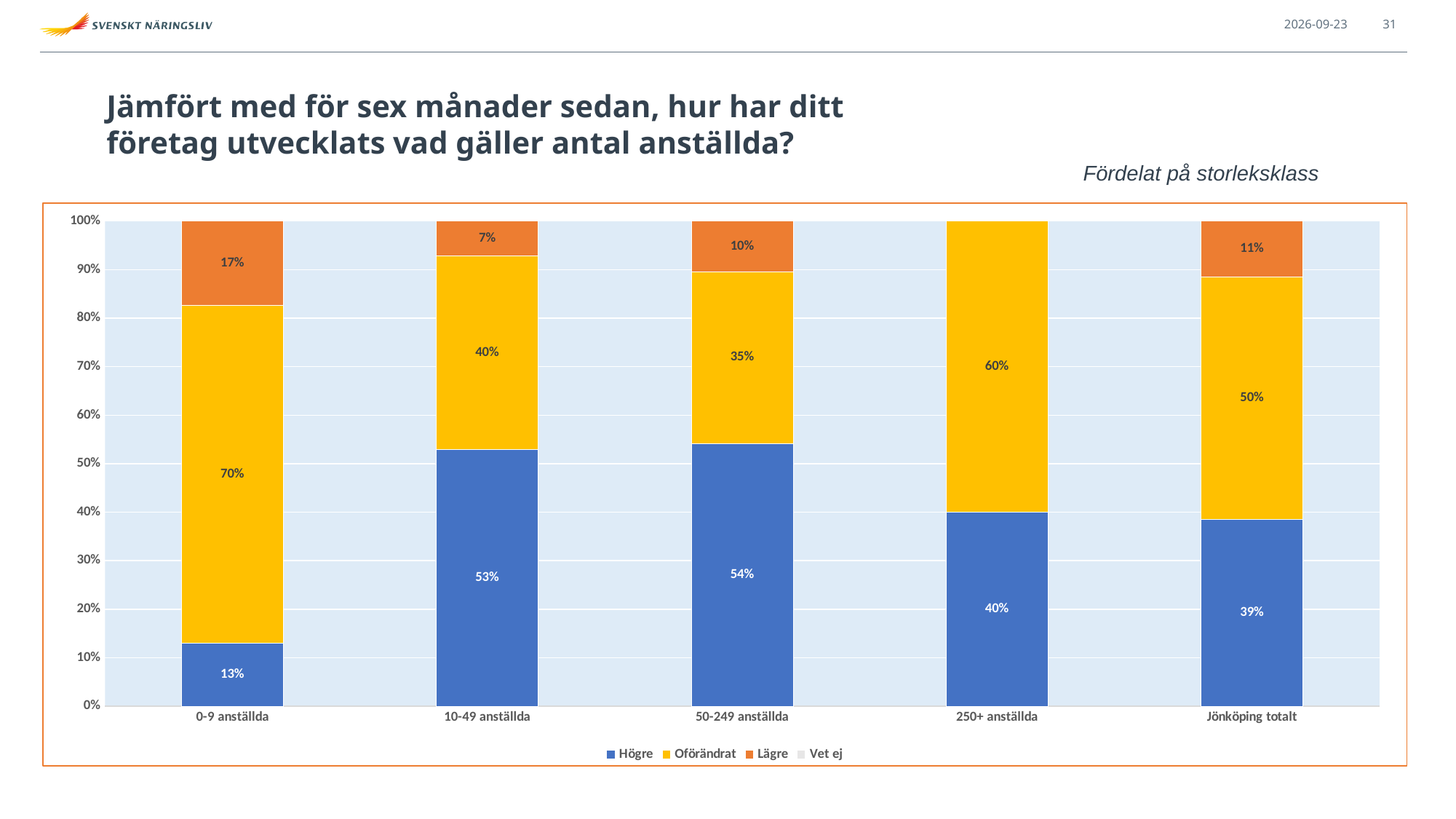
What is the difference between the Oförändrat values for 0-9 anställda and 10-49 anställda? 30 percentage points Which category has the lowest value for Högre? 0-9 anställda What is the value for Oförändrat in the 250+ anställda category? 60% Which series is shown in blue? Högre Which category has the highest value for Högre? 50-249 anställda Which is larger: the Lägre value for 0-9 anställda or for 50-249 anställda? 0-9 anställda What is the value for Lägre in the Jönköping totalt category? 11% How many series does the legend list? 4 Which category has the highest value for Oförändrat? 0-9 anställda What kind of chart is shown on the slide? Stacked bar chart How many categories are shown on the x axis? 5 What is the value for Högre in the 0-9 anställda category? 13%